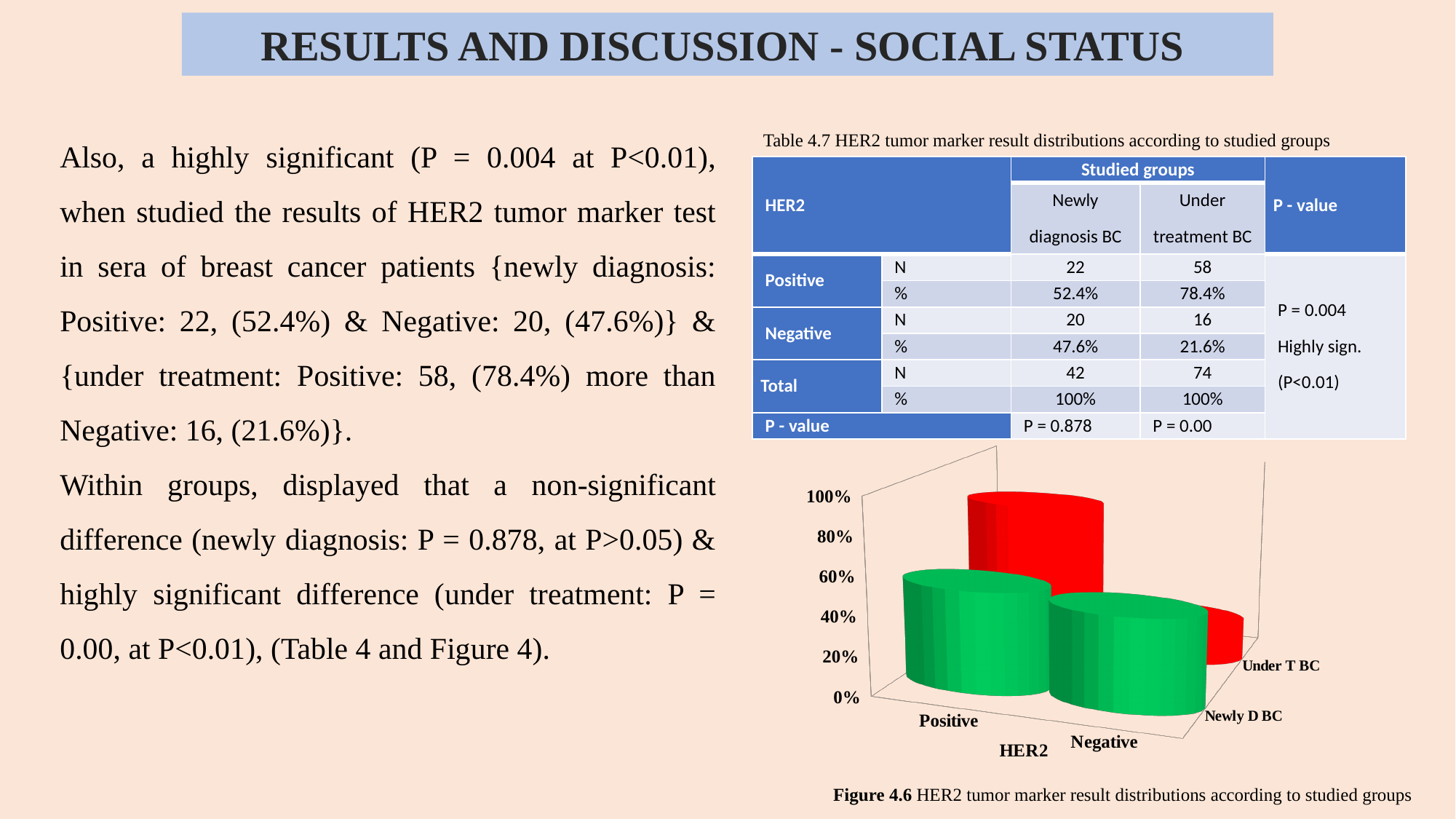
What colour are the bars for the Under T BC group? red What kind of chart is shown in Figure 4.6? bar chart How many studied groups (series) are plotted in the chart? 2 Is the value for Negative in the Newly D BC group greater or less than 60%? less How many HER2 categories are shown on the x axis of the chart? 2 Is the value for Positive in the Newly D BC group greater or less than 40%? greater Which bar in the chart is the shortest? Negative, Under T BC Is the value for Negative in the Under T BC group greater or less than 40%? less For the Positive category, which group has the larger value, Newly D BC or Under T BC? Under T BC In the Under T BC group, which is larger, Positive or Negative? Positive Which bar in the chart is the tallest? Positive, Under T BC